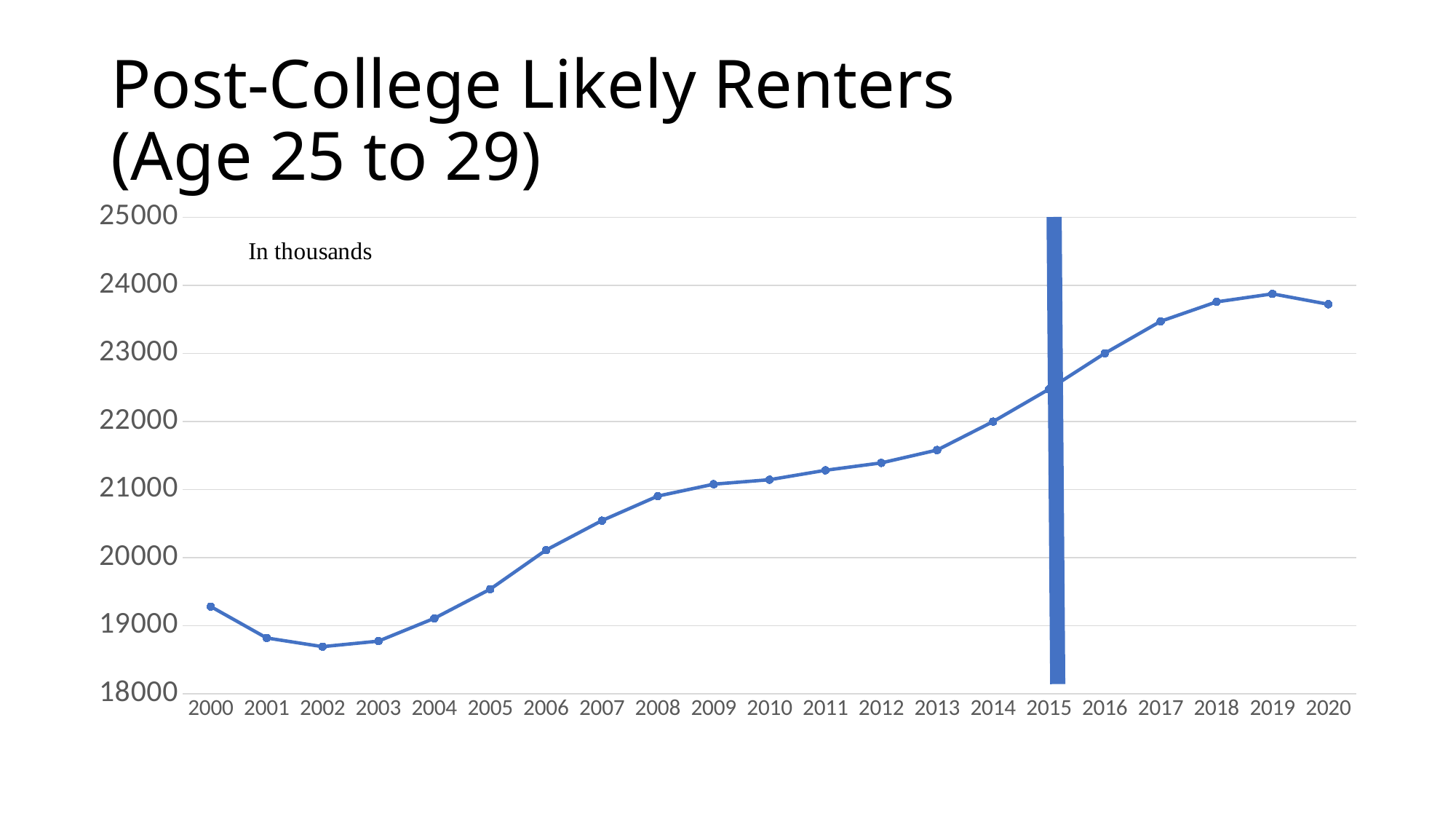
Is the value for 2000 greater or less than 19000? greater Which year has the lowest value? 2002 What kind of chart is shown on the slide? line chart Which is larger, the value for 2006 or the value for 2012? 2012 Which year has the highest value? 2019 How many years are plotted along the x axis? 21 Do the values generally rise or fall from 2003 to 2019? rise Is the value for 2018 greater or less than 23000? greater Is the value for 2002 greater or less than 19000? less What is the title of the chart? Post-College Likely Renters (Age 25 to 29) In what units are the values expressed, according to the note on the chart? In thousands